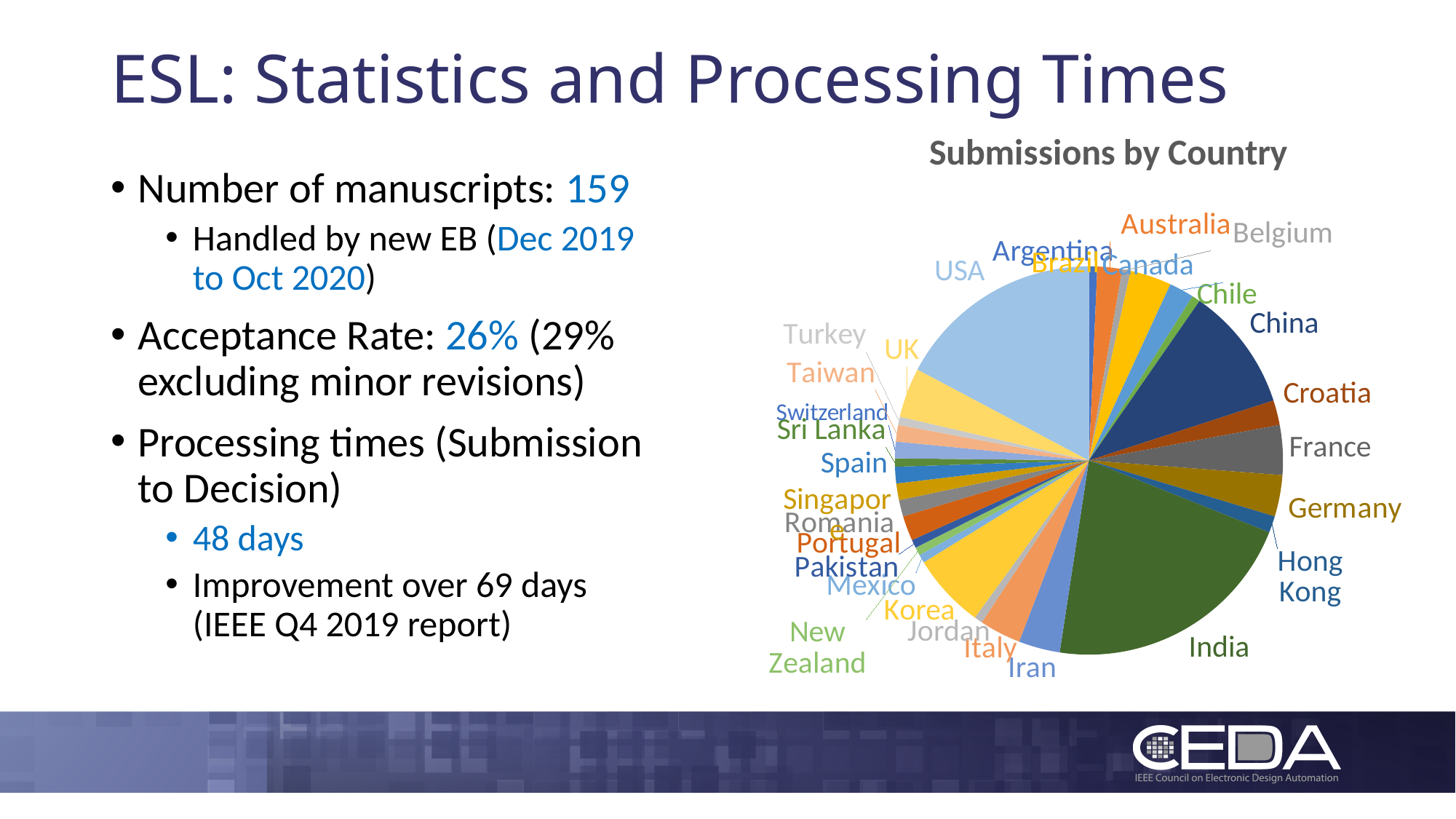
Which slice is larger in the pie chart, India or USA? India Which slice is larger in the pie chart, Germany or Hong Kong? Germany Which slice is larger in the pie chart, India or China? India What is the title of the chart? Submissions by Country What kind of chart is shown on the slide? pie chart How many countries are labelled in the Submissions by Country pie chart? 29 What colour is the India slice in the pie chart? dark green Which country has the largest slice in the Submissions by Country pie chart? India